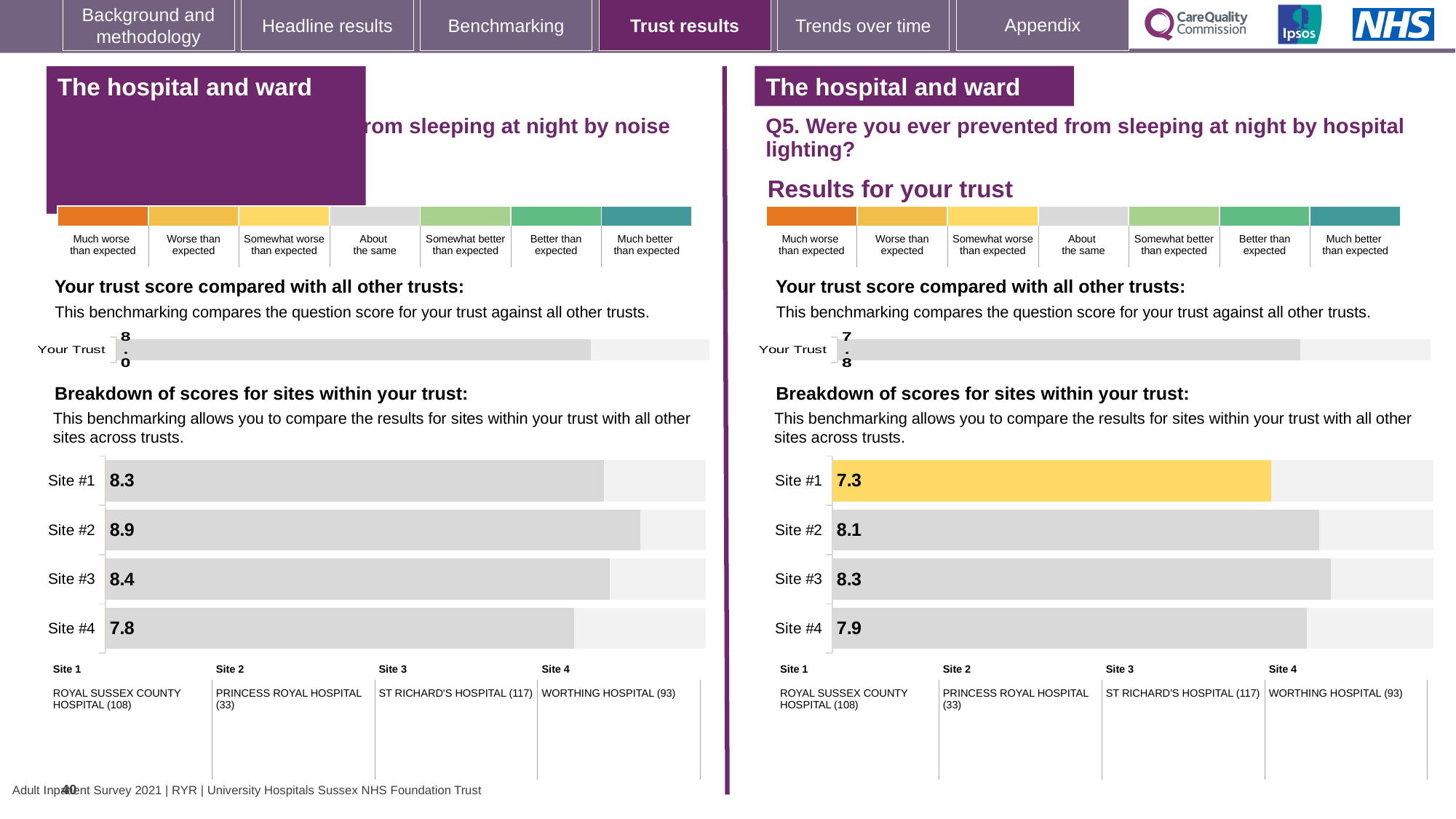
On the right-hand chart (Q5, hospital lighting), what is the score for Site #1? 7.3 On the left-hand chart (sleeping at night by noise), what is the score for Site #2? 8.9 On the left-hand chart (sleeping at night by noise), what is the 'Your Trust' score compared with all other trusts? 8.0 On the left-hand chart (sleeping at night by noise), what is the difference between the scores for Site #2 and Site #4? 1.1 On the left-hand chart (sleeping at night by noise), which is larger: the score for Site #3 or Site #4? Site #3 On the right-hand chart (Q5, hospital lighting), which site has the lowest score? Site #1 On the left-hand chart (sleeping at night by noise), how many sites are shown in the breakdown of scores? 4 On the right-hand chart (Q5, hospital lighting), what is the difference between the scores for Site #3 and Site #1? 1.0 On the right-hand chart (Q5, hospital lighting), what is the 'Your Trust' score compared with all other trusts? 7.8 On the left-hand chart (sleeping at night by noise), which site has the highest score? Site #2 On the right-hand chart (Q5, hospital lighting), which site's bar is coloured yellow rather than grey? Site #1 What type of chart is used for the breakdown of scores for sites within your trust? Bar chart